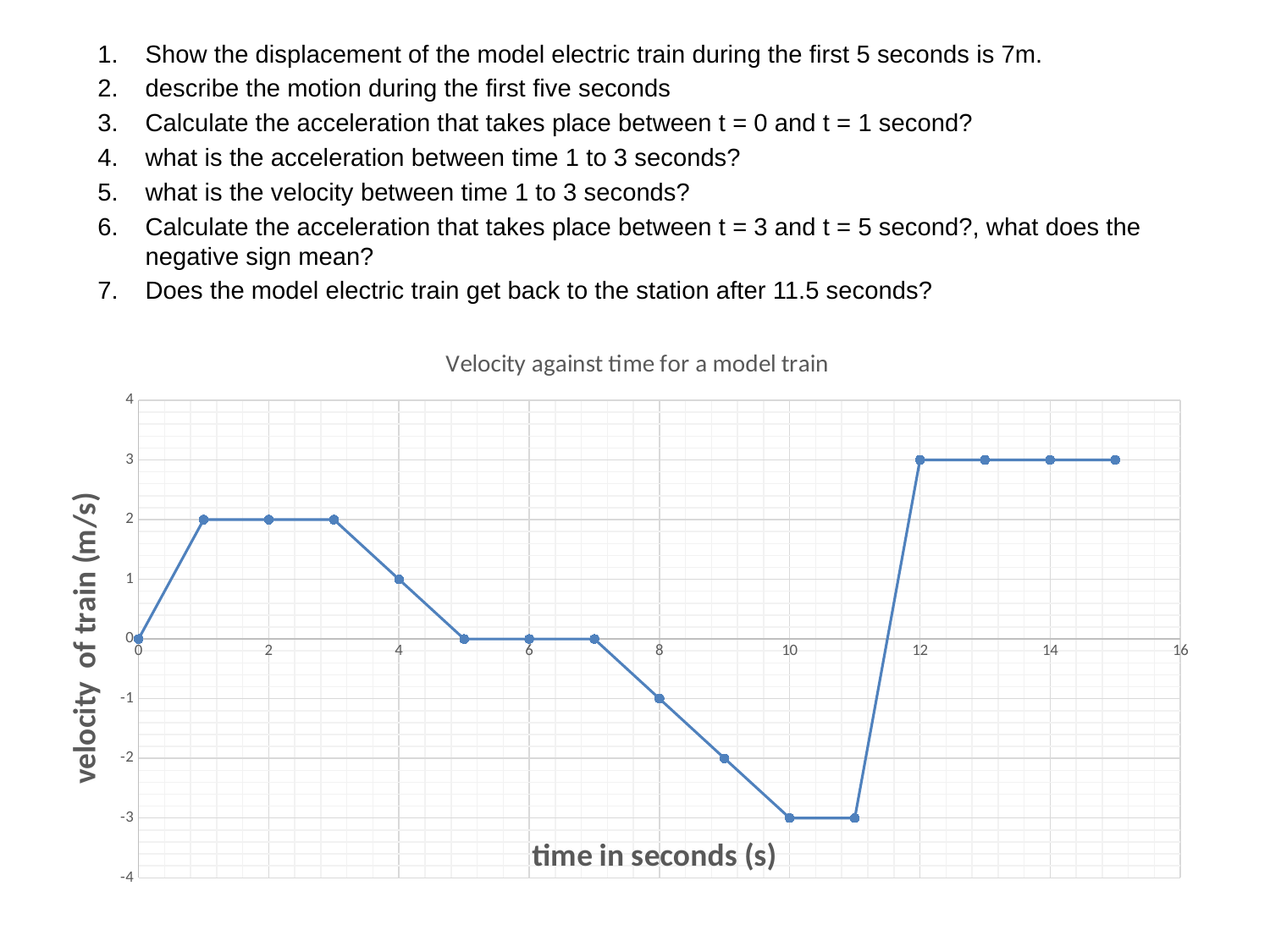
What is the label of the vertical axis of the chart? velocity of train (m/s) What is the velocity of the train at time 4 seconds? 1 Does the velocity rise or fall between time 6 seconds and time 10 seconds? fall What is the velocity of the train at time 10 seconds? -3 What is the velocity of the train at time 12 seconds? 3 What is the title of the chart? Velocity against time for a model train What kind of chart is shown on the slide? line chart What is the highest velocity plotted on the chart? 3 What is the velocity of the train at time 6 seconds? 0 What is the velocity of the train at time 2 seconds? 2 What is the lowest velocity plotted on the chart? -3 Which is larger, the velocity at time 2 seconds or the velocity at time 8 seconds? time 2 seconds